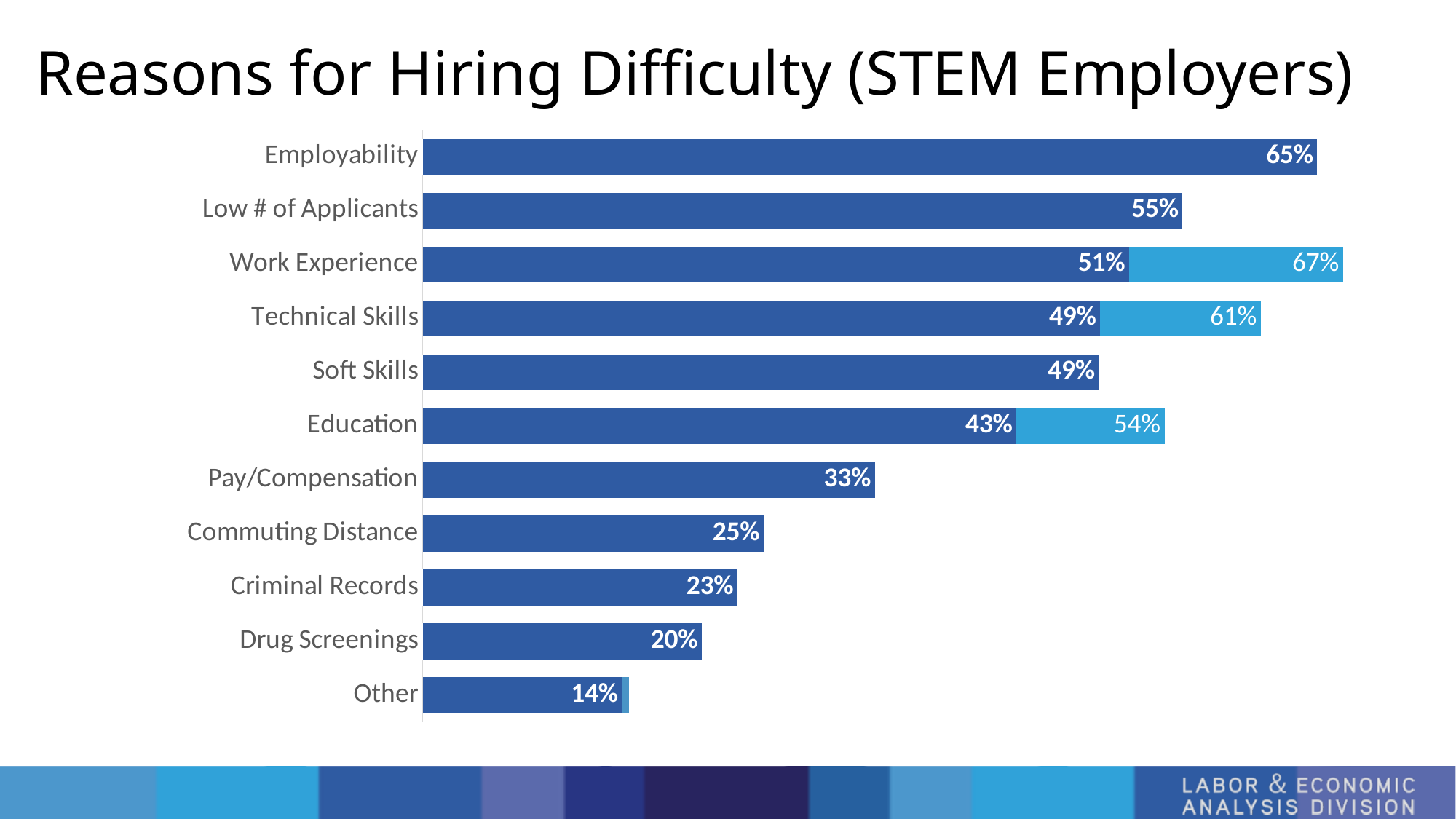
What is the dark blue value for Employability? 65% Which reason has the highest dark blue value? Employability Which has a larger dark blue value, Commuting Distance or Criminal Records? Commuting Distance What is the light blue value shown for Work Experience? 67% How many reasons (categories) are listed on the chart? 11 What is the difference between the dark blue values for Employability and Low # of Applicants? 10% Which category has the lowest dark blue value? Other What is the difference between the light blue and dark blue values for Technical Skills? 12% What type of chart is shown on the slide? bar chart What is the dark blue value for Low # of Applicants? 55% What is the dark blue value for Pay/Compensation? 33% What is the title of the chart? Reasons for Hiring Difficulty (STEM Employers)